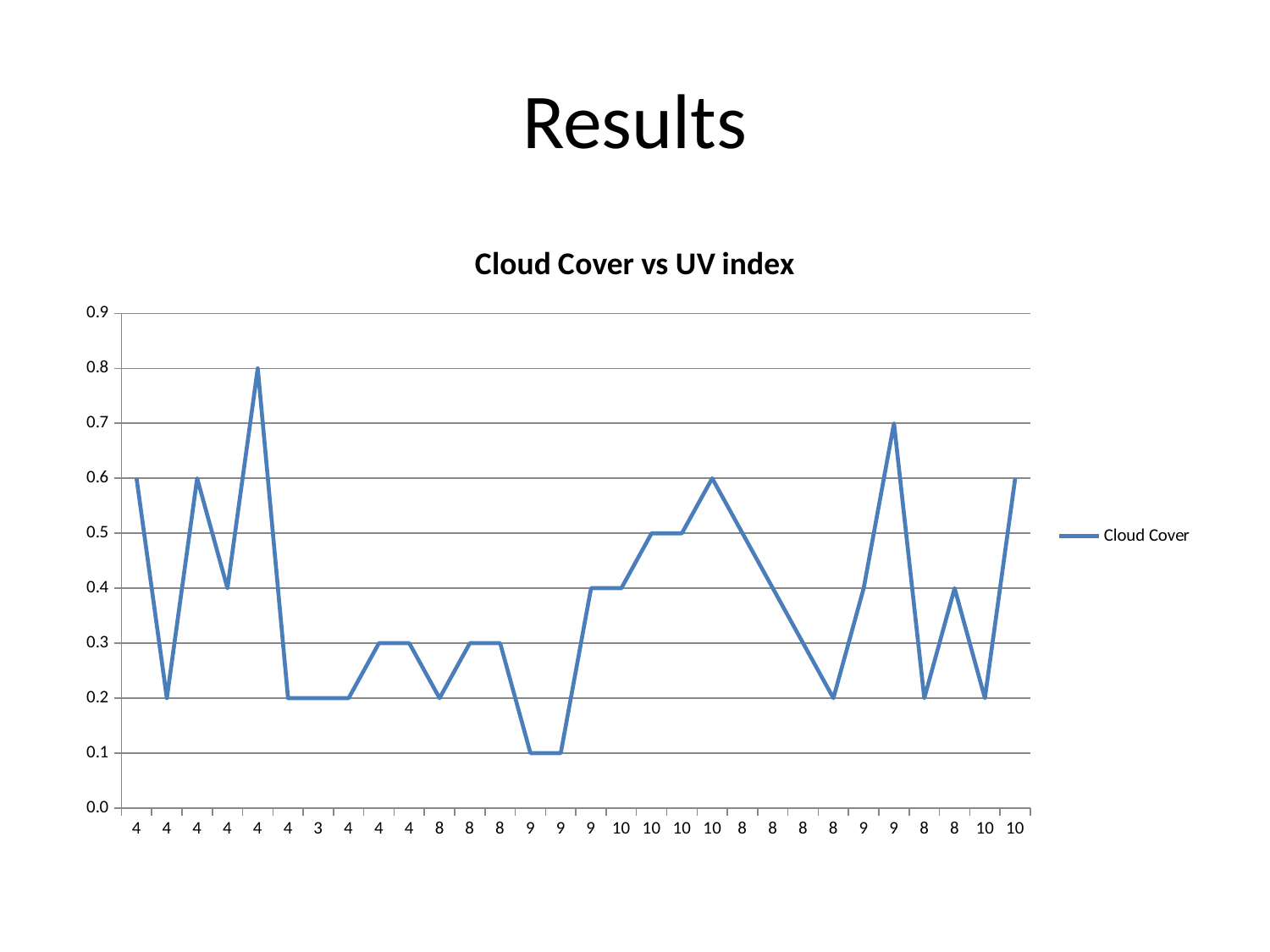
How many series does the legend list? 1 What is the Cloud Cover value at the only point labelled 3 on the x axis? 0.2 Is the peak Cloud Cover value greater or less than 0.7? greater What kind of chart is shown on the slide? line chart What is the Cloud Cover value of the first point on the chart? 0.6 Which is larger, the Cloud Cover value of the first point or of the second point? the first point What is the title of the chart? Cloud Cover vs UV index What is the lowest Cloud Cover value plotted on the chart? 0.1 How many data points are plotted on the chart? 30 What is the difference between the highest and lowest Cloud Cover values on the chart? 0.7 What is the highest Cloud Cover value plotted on the chart? 0.8 What is the name of the series shown in the legend? Cloud Cover